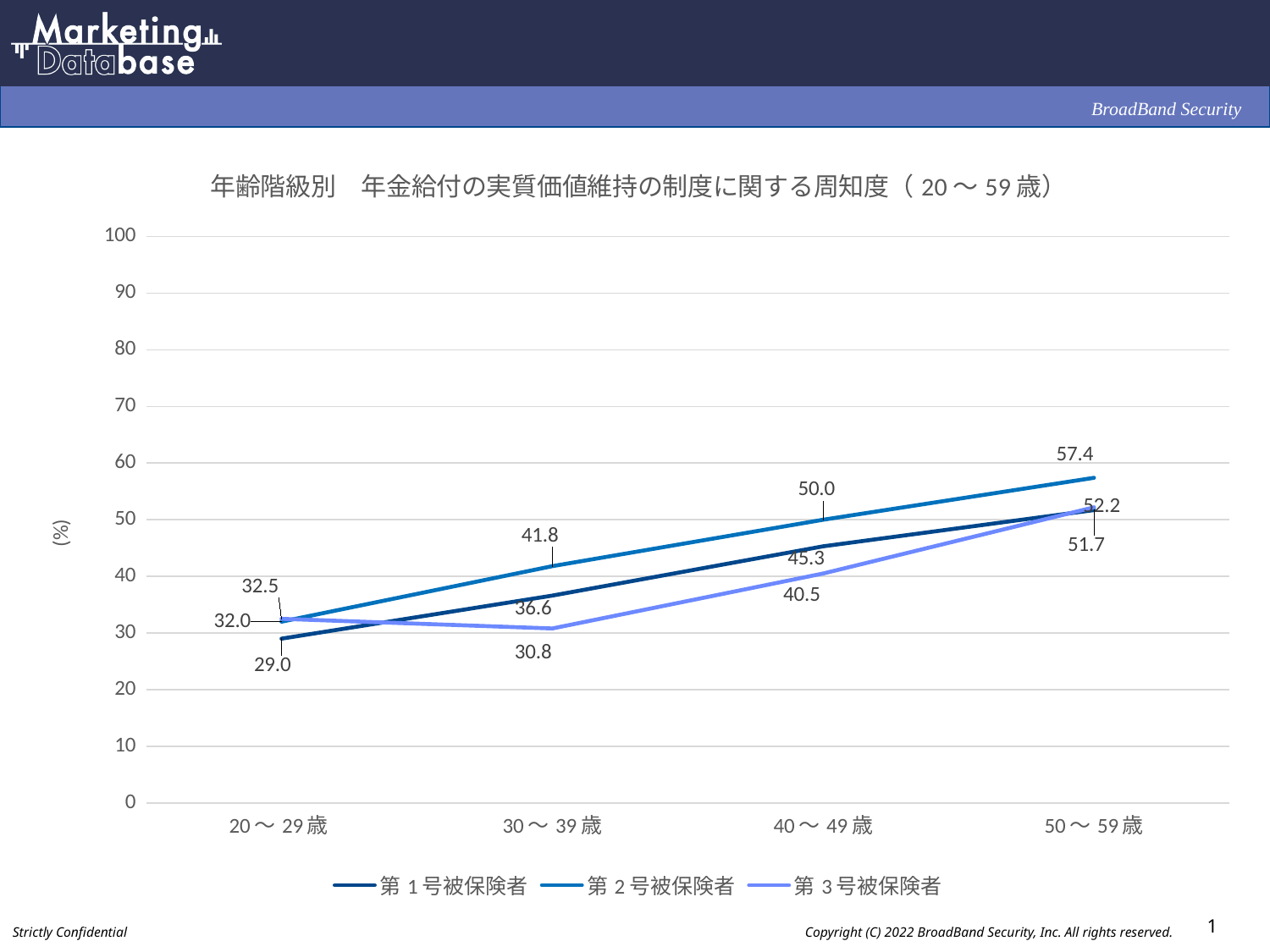
How many series does the legend list? 3 In the 30〜39歳 group, which is larger: 第1号被保険者 or 第3号被保険者? 第1号被保険者 What is the value for 第1号被保険者 in the 20〜29歳 group? 29.0 What is the value for 第2号被保険者 in the 50〜59歳 group? 57.4 Does the value for 第2号被保険者 rise or fall from 20〜29歳 to 50〜59歳? rise Which age group has the highest value for 第2号被保険者? 50〜59歳 What is the value for 第2号被保険者 in the 40〜49歳 group? 50.0 Which age group has the lowest value for 第1号被保険者? 20〜29歳 What is the value for 第3号被保険者 in the 30〜39歳 group? 30.8 What is the difference between 第2号被保険者 and 第3号被保険者 in the 40〜49歳 group? 9.5 What type of chart is shown on the slide? line chart How many age groups are shown on the x axis? 4